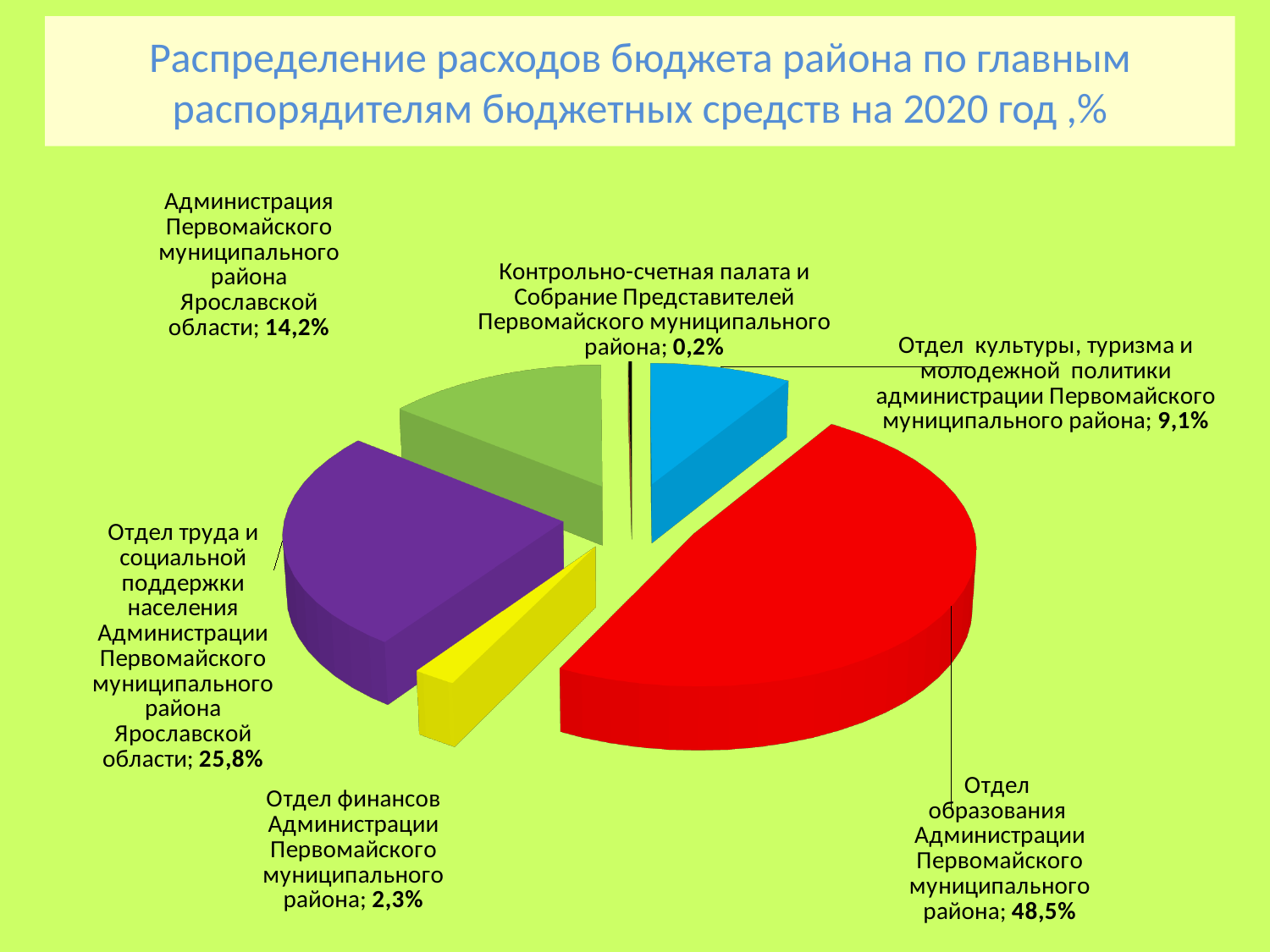
What is the value shown for Отдел труда и социальной поддержки населения Администрации Первомайского муниципального района Ярославской области? 25,8% Which is larger: the share for Администрация Первомайского муниципального района Ярославской области or the share for Отдел культуры, туризма и молодежной политики? Администрация Первомайского муниципального района Ярославской области What share is shown for Отдел финансов Администрации Первомайского муниципального района? 2,3% What is the difference between the shares of Отдел образования (48,5%) and Отдел труда и социальной поддержки населения (25,8%)? 22,7% Which category has the smallest share of the pie? Контрольно-счетная палата и Собрание Представителей Первомайского муниципального района What percentage is shown for Администрация Первомайского муниципального района Ярославской области? 14,2% What colour is the slice for Отдел образования Администрации Первомайского муниципального района? Red Which category has the largest share of the pie? Отдел образования Администрации Первомайского муниципального района What is the value for Отдел культуры, туризма и молодежной политики администрации Первомайского муниципального района? 9,1% What share of the budget expenses goes to Отдел образования Администрации Первомайского муниципального района? 48,5% What kind of chart is shown on the slide? Pie chart How many slices does the pie chart have? 6